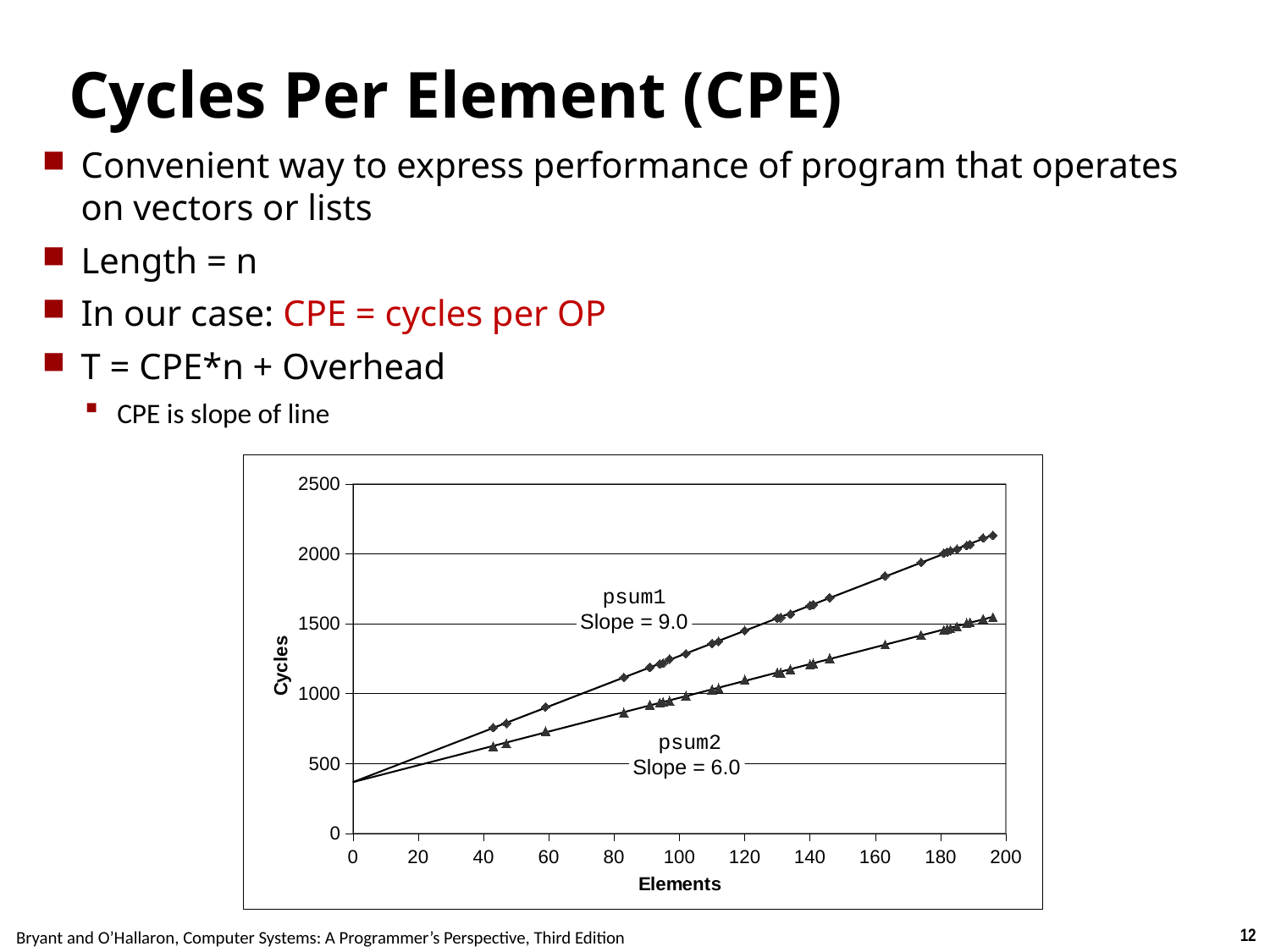
Is the value for psum1 at about 60 elements greater or less than 1000 cycles? less What kind of chart is shown on the slide? Scatter chart with trend lines Is the value for psum1 at about 195 elements greater or less than 2000 cycles? greater Do the cycles for psum1 rise or fall as the number of elements increases? Rise Which series reaches the higher number of cycles at around 195 elements? psum1 Which series has the larger slope, psum1 or psum2? psum1 How many data series are plotted on the chart? 2 What is the slope of the psum1 line according to the chart annotation? 9.0 What is the label of the x axis? Elements Is the value for psum2 at about 195 elements greater or less than 2000 cycles? less What is the slope of the psum2 line according to the chart annotation? 6.0 What is the label of the y axis? Cycles